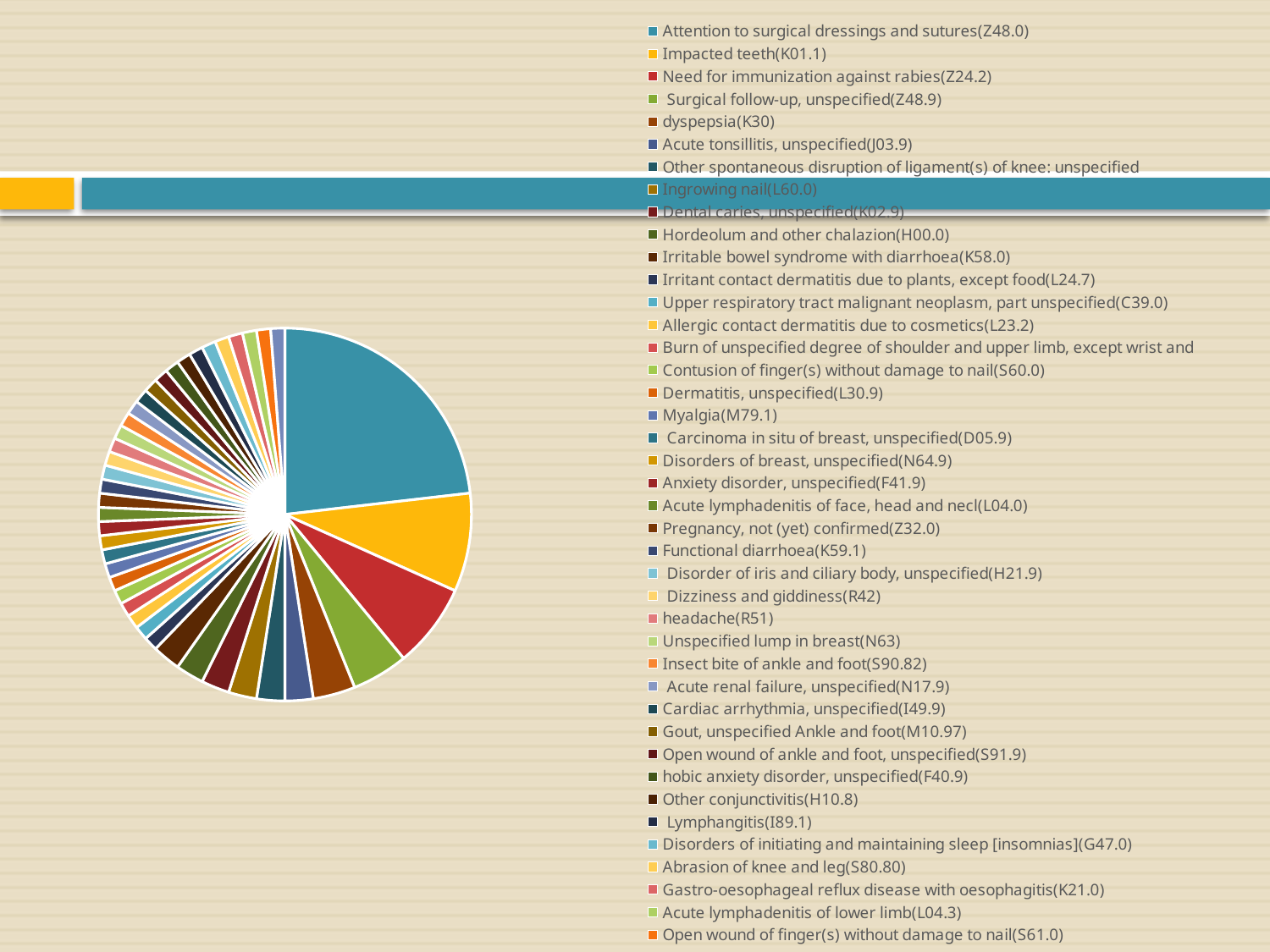
Which category is listed first in the legend? Attention to surgical dressings and sutures(Z48.0) Which slice is larger: Impacted teeth(K01.1) or Myalgia(M79.1)? Impacted teeth(K01.1) What colour is the slice for Attention to surgical dressings and sutures(Z48.0)? Teal Does the largest slice of the pie take up more or less than half of the pie? less Which slice is larger: Attention to surgical dressings and sutures(Z48.0) or Impacted teeth(K01.1)? Attention to surgical dressings and sutures(Z48.0) What kind of chart is shown on the slide? Pie chart Which category has the largest slice of the pie? Attention to surgical dressings and sutures(Z48.0)